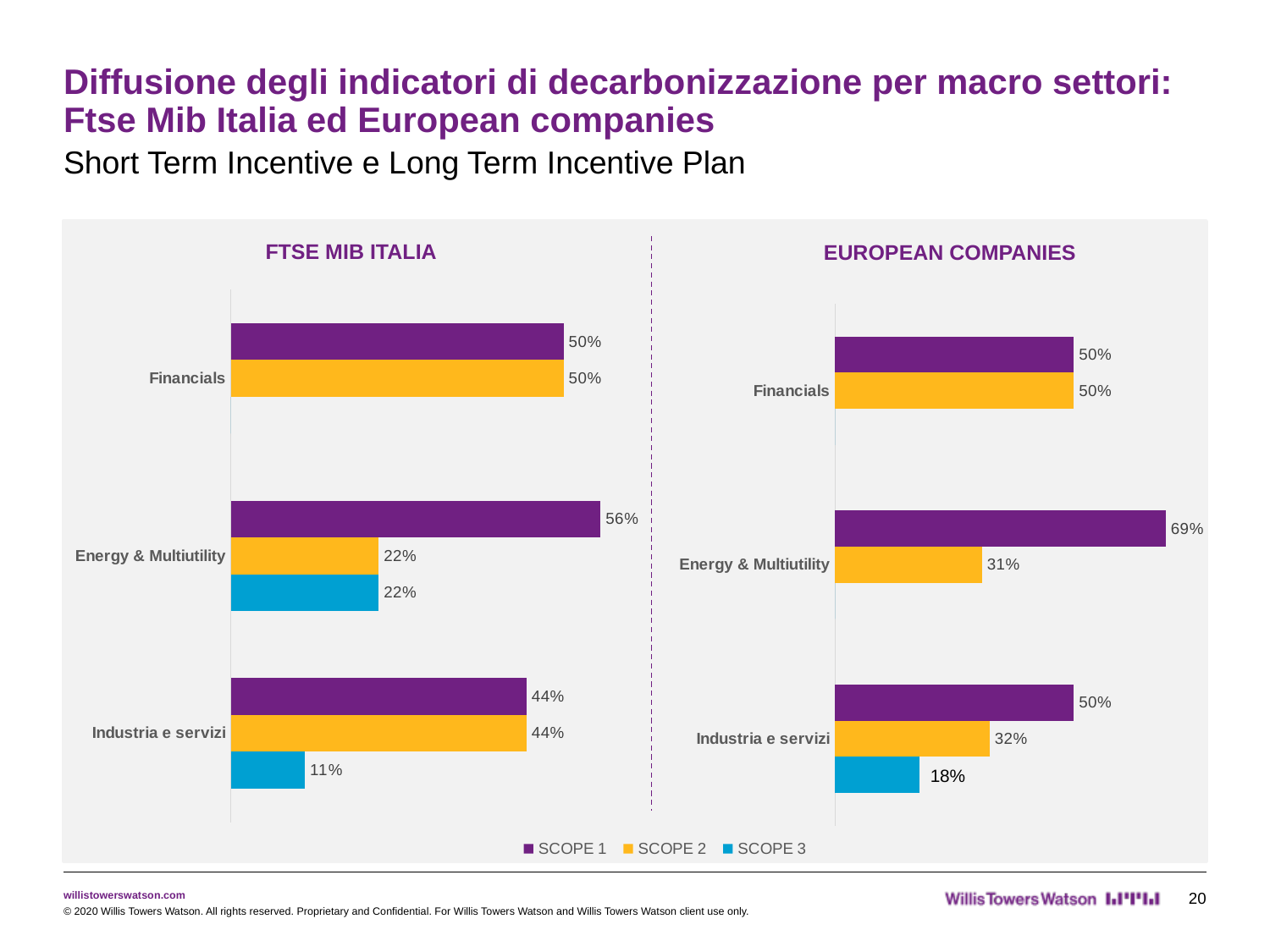
In the FTSE MIB ITALIA chart, what is the difference between the SCOPE 1 and SCOPE 2 values for Energy & Multiutility? 34% In the FTSE MIB ITALIA chart, which category has the lowest SCOPE 2 value? Energy & Multiutility In the FTSE MIB ITALIA chart, what is the SCOPE 3 value for Industria e servizi? 11% Which is larger: the SCOPE 1 value for Energy & Multiutility in the FTSE MIB ITALIA chart or in the EUROPEAN COMPANIES chart? EUROPEAN COMPANIES In the EUROPEAN COMPANIES chart, what is the difference between the SCOPE 2 and SCOPE 3 values for Industria e servizi? 14% In the FTSE MIB ITALIA chart, what is the SCOPE 1 value for Energy & Multiutility? 56% In the EUROPEAN COMPANIES chart, what is the SCOPE 3 value for Industria e servizi? 18% In the EUROPEAN COMPANIES chart, what is the SCOPE 2 value for Energy & Multiutility? 31% In the EUROPEAN COMPANIES chart, which category has the highest SCOPE 1 value? Energy & Multiutility How many series does the legend list? 3 What kind of chart is the EUROPEAN COMPANIES chart? Bar chart How many categories are shown in the FTSE MIB ITALIA chart? 3